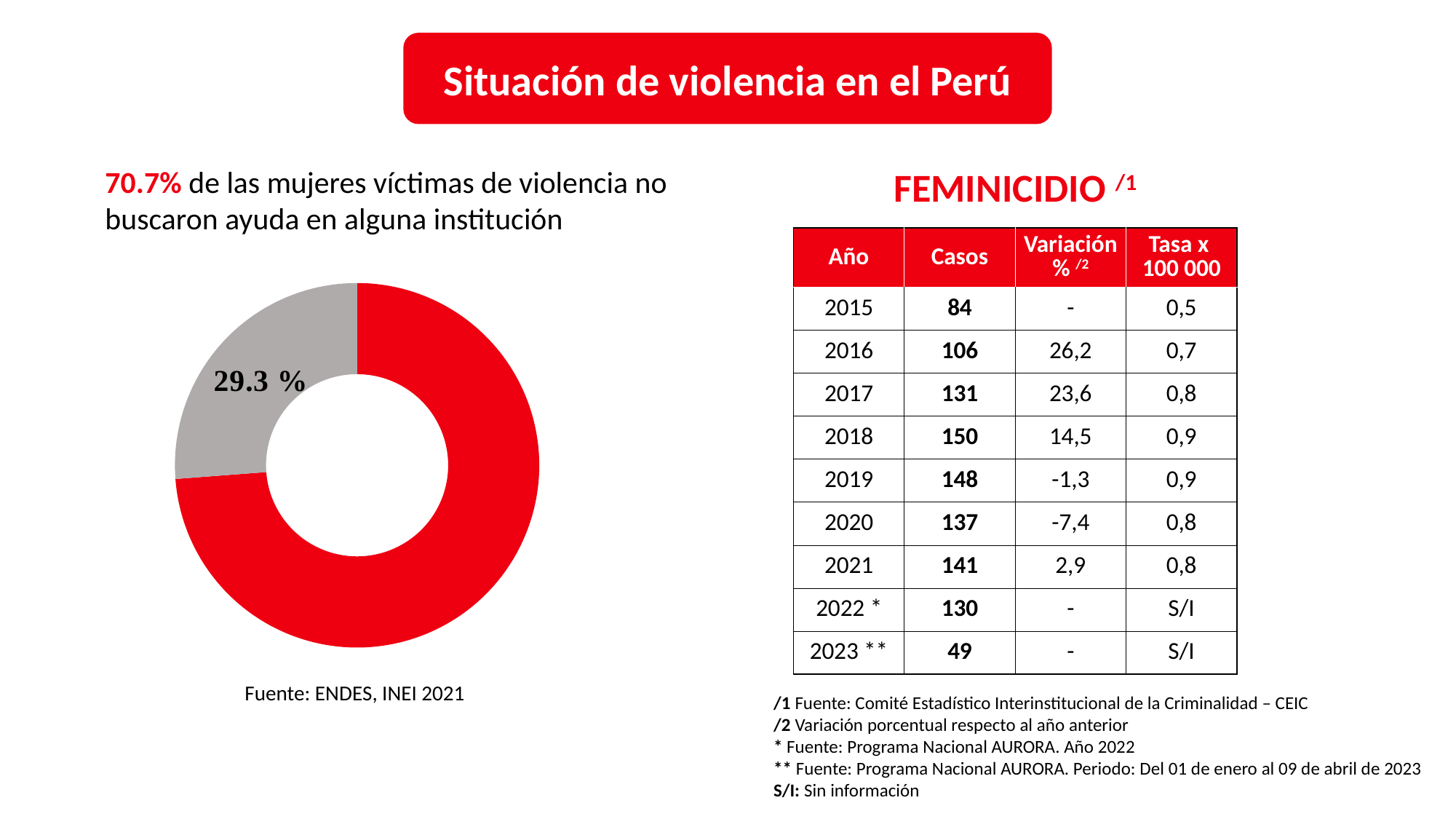
How many slices does the pie chart have? 2 What value is labelled on the grey slice of the pie chart? 29.3 % What share of the pie chart does the grey slice represent? 29.3 % What two colours are used for the slices of the pie chart? red and grey Which slice of the pie chart is larger, the red one or the grey one? red Which colour slice is the smallest in the pie chart? grey What source is cited below the pie chart? Fuente: ENDES, INEI 2021 Which colour slice is the largest in the pie chart? red What kind of chart is shown on the left side of the slide? doughnut chart